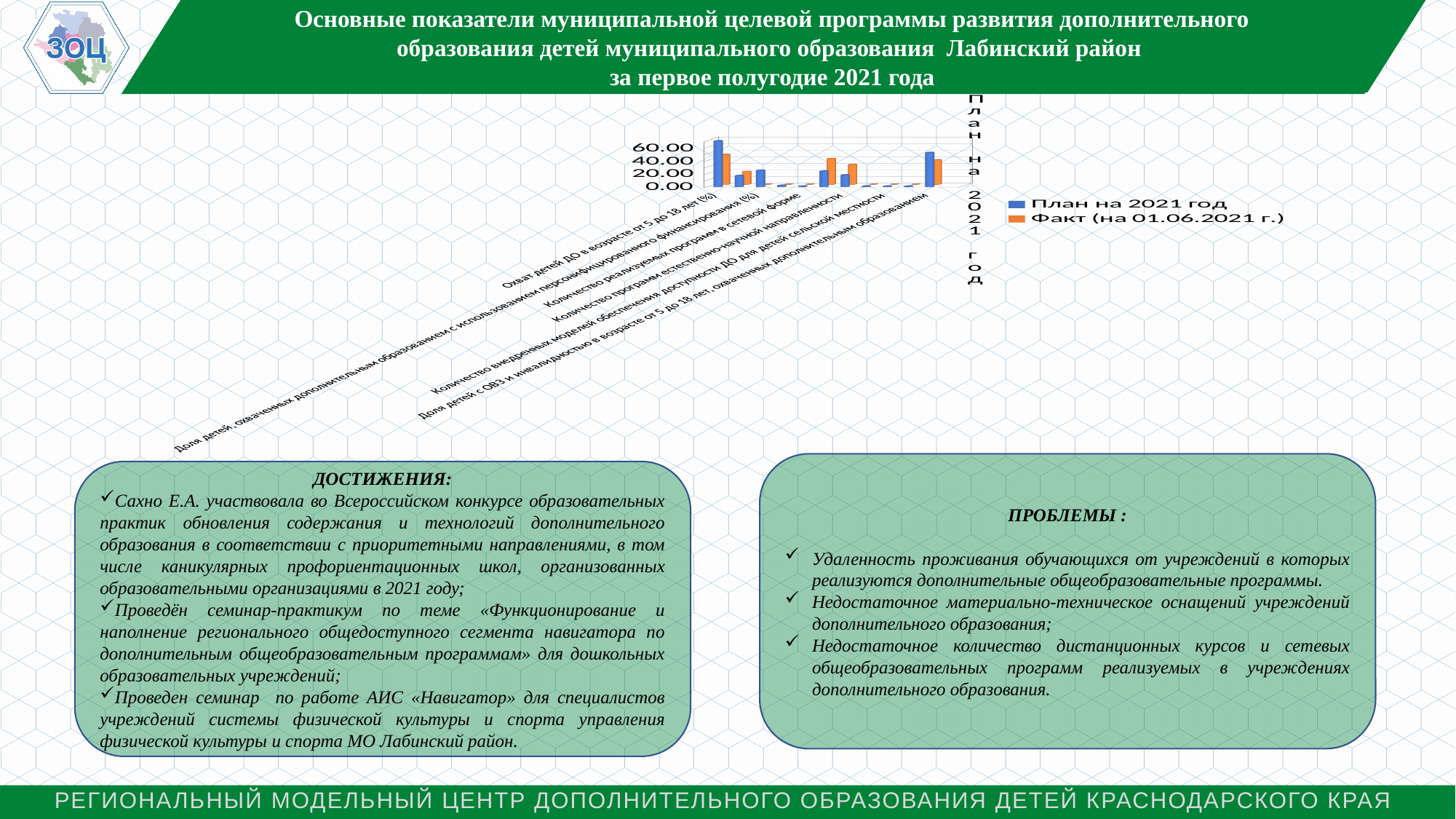
How many series does the chart legend list? 2 What is the highest tick value shown on the chart's vertical axis? 60.00 What kind of chart is shown on the slide? bar chart What are the two series named in the chart legend? План на 2021 год; Факт (на 01.06.2021 г.) Which category has the highest 'План на 2021 год' value? Охват детей ДО в возрасте от 5 до 18 лет (%) For 'Охват детей ДО в возрасте от 5 до 18 лет (%)', which is larger: 'План на 2021 год' or 'Факт (на 01.06.2021 г.)'? План на 2021 год Is the 'План на 2021 год' value for 'Охват детей ДО в возрасте от 5 до 18 лет (%)' greater or less than 40? greater